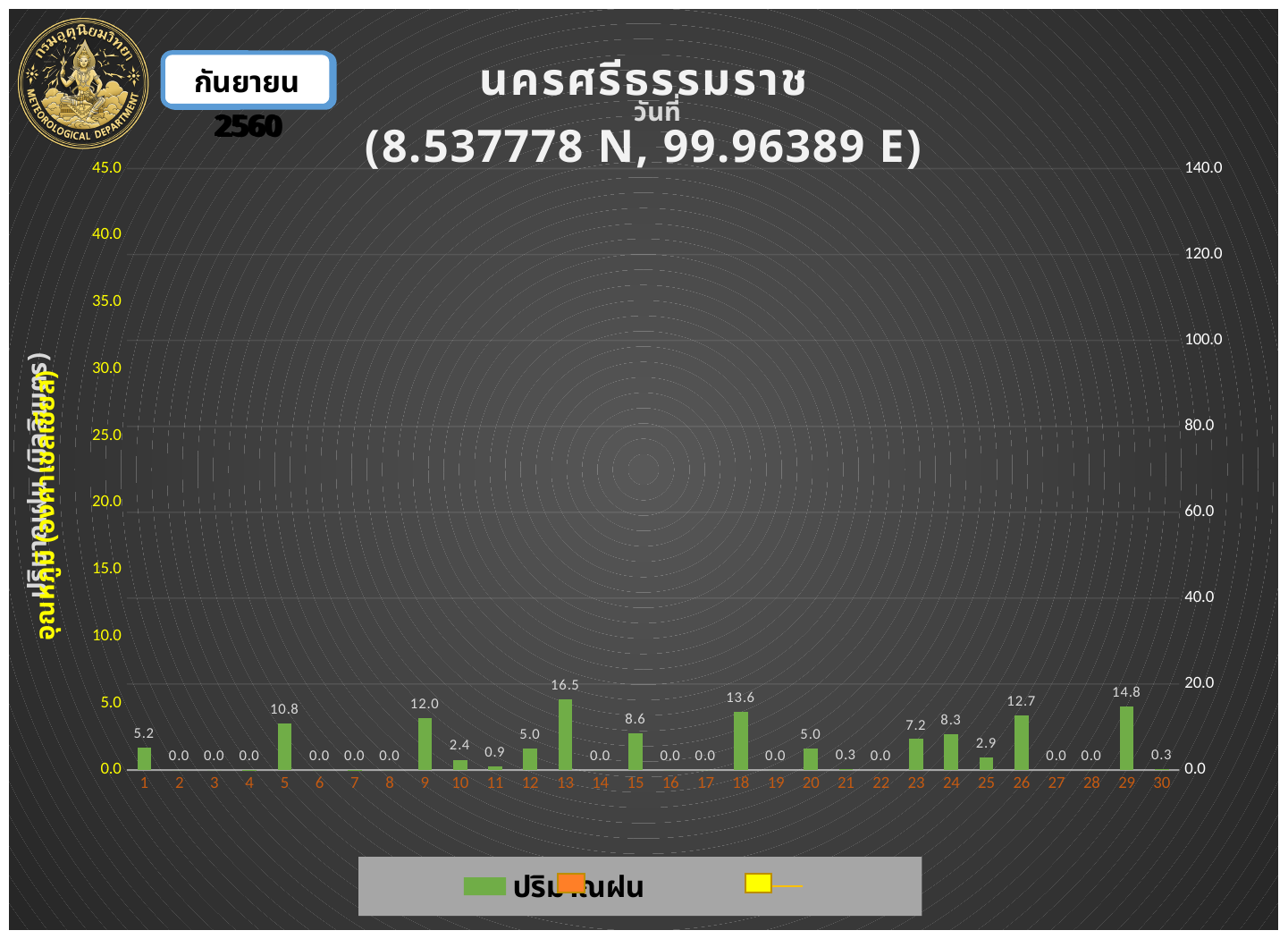
What is the rainfall value shown for day 5? 10.8 How many days are shown on the x axis of the chart? 30 What is the rainfall value shown for day 13? 16.5 Which has the larger rainfall value, day 15 or day 24? day 15 Which day has the highest rainfall value? 13 What coordinates are given in the chart title? 8.537778 N, 99.96389 E Which has the larger rainfall value, day 18 or day 26? day 18 What is the rainfall value shown for day 21? 0.3 What is the rainfall value shown for day 29? 14.8 What kind of chart is shown on the slide? bar chart What is the difference between the rainfall values for day 13 and day 29? 1.7 What is the difference between the rainfall values for day 9 and day 10? 9.6